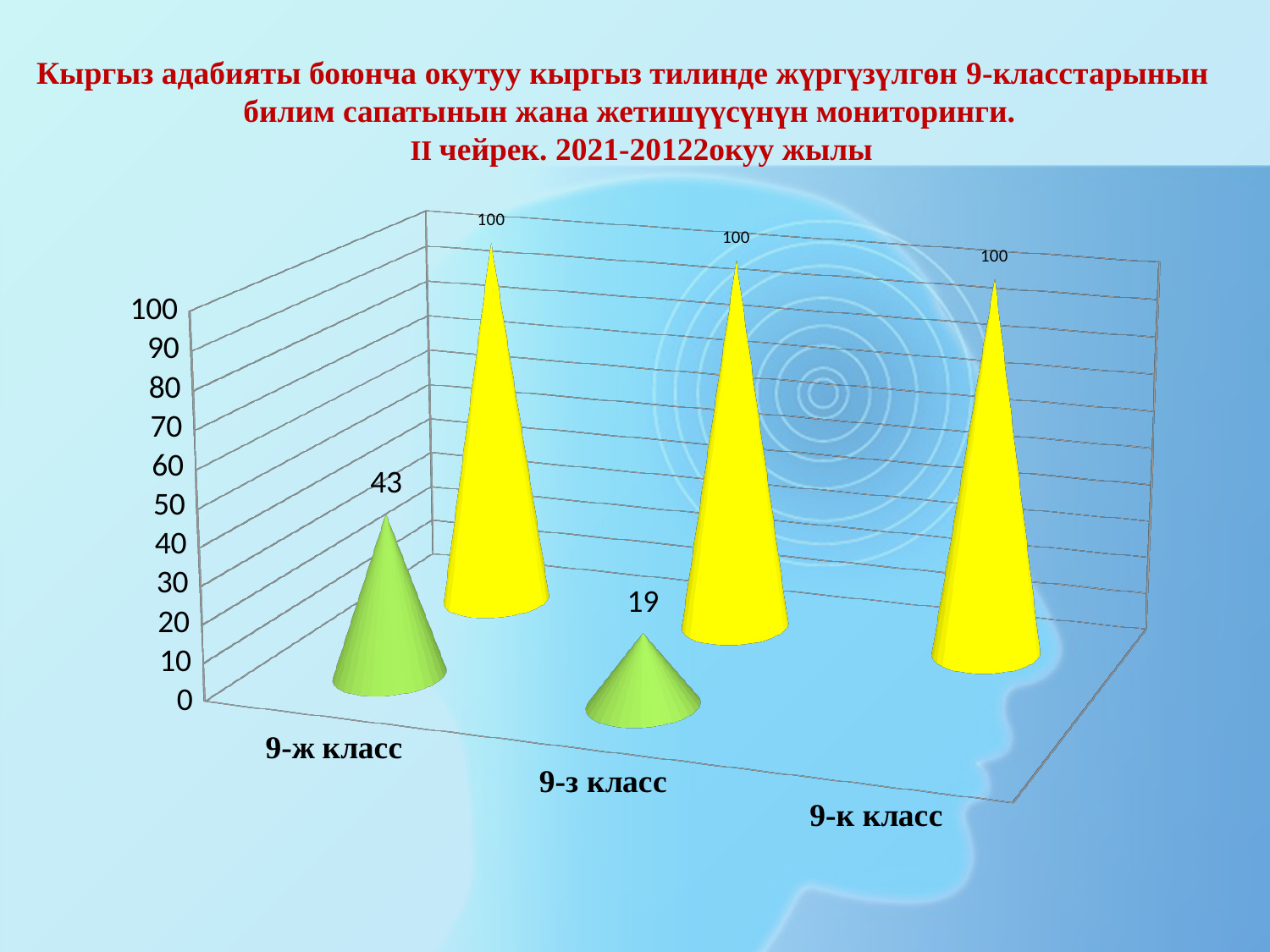
What is the value of the yellow cone for 9-ж класс? 100 What is the value of the green cone for 9-з класс? 19 How many classes are shown on the x axis of the chart? 3 What is the difference between the yellow and green cone values for 9-ж класс? 57 Which class has the lowest green cone value shown? 9-з класс What is the value of the yellow cone for 9-к класс? 100 Which is larger: the green value for 9-ж класс or the green value for 9-з класс? 9-ж класс What is the highest value shown on the vertical axis of the chart? 100 Which class has the highest green cone value? 9-ж класс What is the difference between the green cone values for 9-ж класс and 9-з класс? 24 Is the green cone value for 9-з класс greater or less than 20? less What is the value of the green cone for 9-ж класс? 43